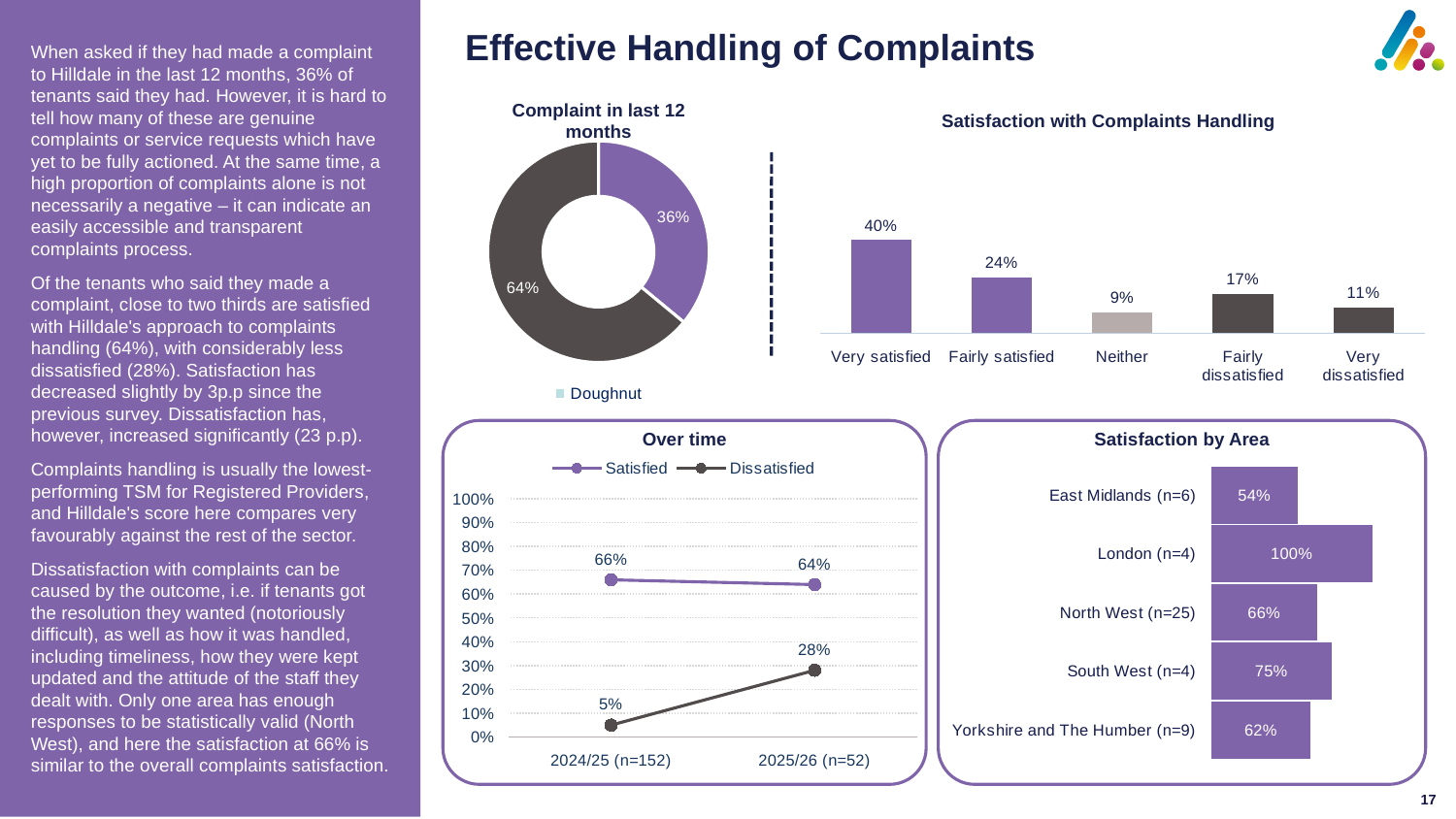
In the 'Satisfaction by Area' chart, which is larger: South West (n=4) or Yorkshire and The Humber (n=9)? South West (n=4) How many categories are shown in the 'Satisfaction with Complaints Handling' chart? 5 What kind of chart is 'Complaint in last 12 months'? Doughnut chart In the 'Complaint in last 12 months' chart, what share of the doughnut is labelled 36%? 36% How many series does the legend of the 'Over time' chart list? 2 In the 'Satisfaction by Area' chart, what is the value for North West (n=25)? 66% In the 'Satisfaction with Complaints Handling' chart, what is the value for Very satisfied? 40% In the 'Over time' chart, what is the Dissatisfied value for 2025/26 (n=52)? 28% In the 'Satisfaction with Complaints Handling' chart, which category has the lowest value? Neither In the 'Satisfaction by Area' chart, which area has the highest value? London (n=4) In the 'Satisfaction with Complaints Handling' chart, what is the difference between Fairly satisfied and Fairly dissatisfied? 7% In the 'Over time' chart, does the Satisfied line rise or fall from 2024/25 to 2025/26? Fall